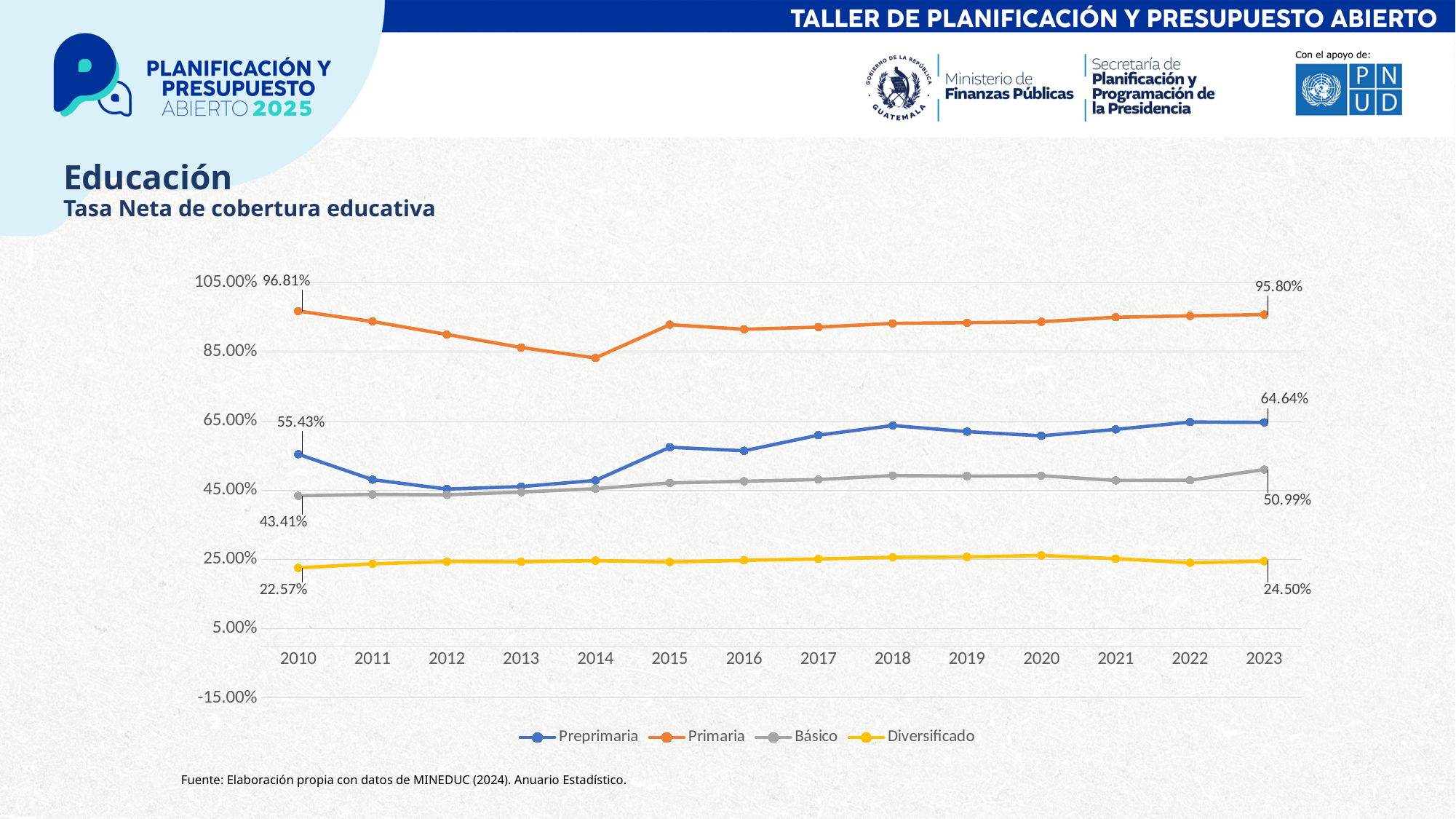
What was the Preprimaria net coverage rate in 2023? 64.64% What was the Diversificado net coverage rate in 2023? 24.50% Which series has the lowest values across all years? Diversificado What was the Primaria net coverage rate in 2010? 96.81% Is the Primaria value for 2014 greater or less than 85.00%? less What type of chart is shown on the slide? Line chart How many series does the legend list? 4 By how many percentage points did the Preprimaria rate change from 2010 (55.43%) to 2023 (64.64%)? 9.21 percentage points Which series has the highest values across all years? Primaria How many years are shown on the x axis? 14 What was the Básico net coverage rate in 2010? 43.41% Did the Básico rate rise or fall between 2010 and 2023? Rise